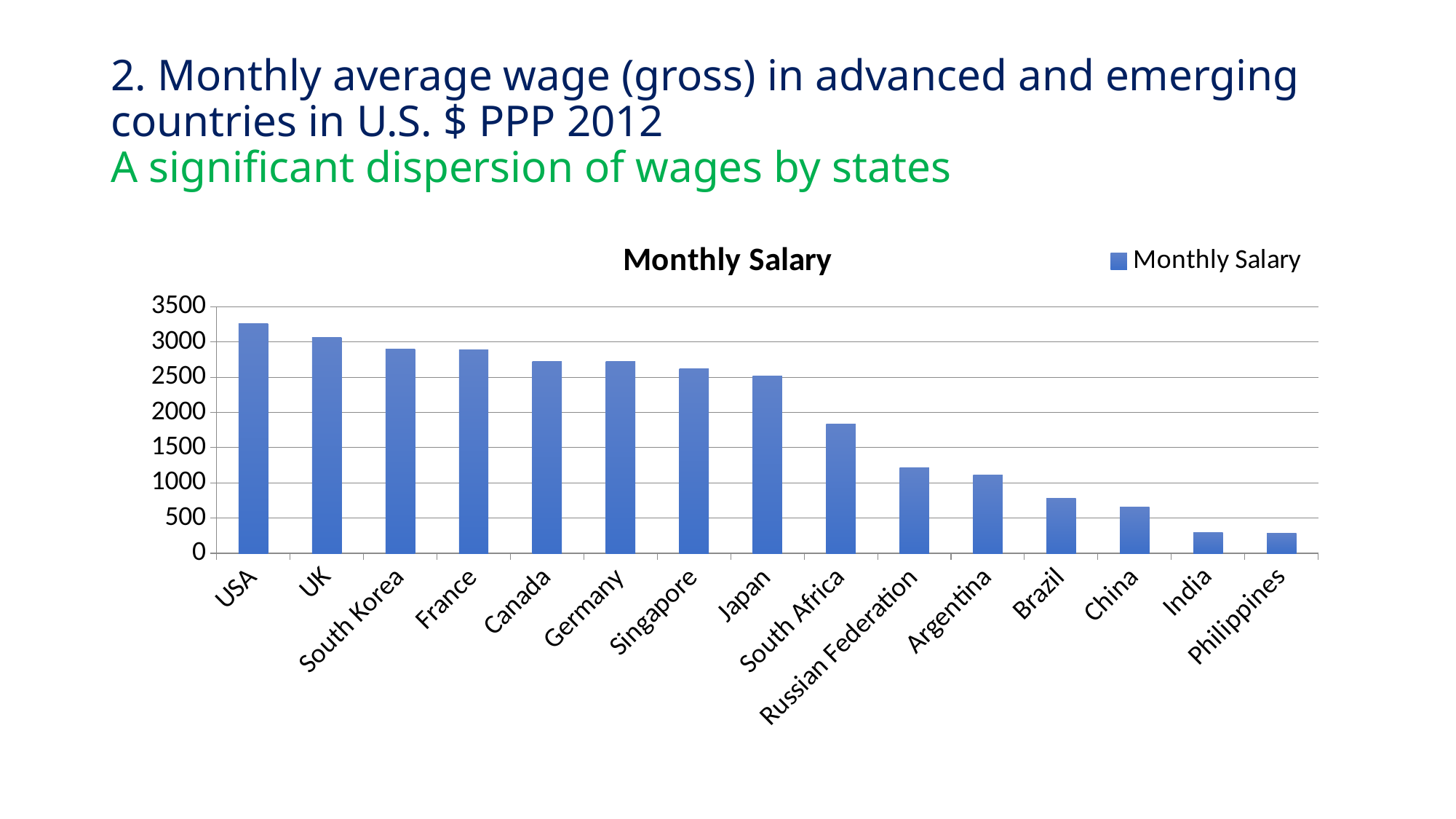
How many countries are shown on the x axis? 15 Do the values rise or fall from left to right along the x axis? fall Is the value for Japan greater or less than 2000? greater Is the value for South Africa greater or less than 2000? less Is the value for Brazil greater or less than 1000? less How many series does the legend list? 1 What is the title of the chart? Monthly Salary What type of chart is shown on the slide? bar chart Which has a larger monthly salary, UK or Japan? UK Which country has the highest monthly salary? USA Which country has the lowest monthly salary? Philippines